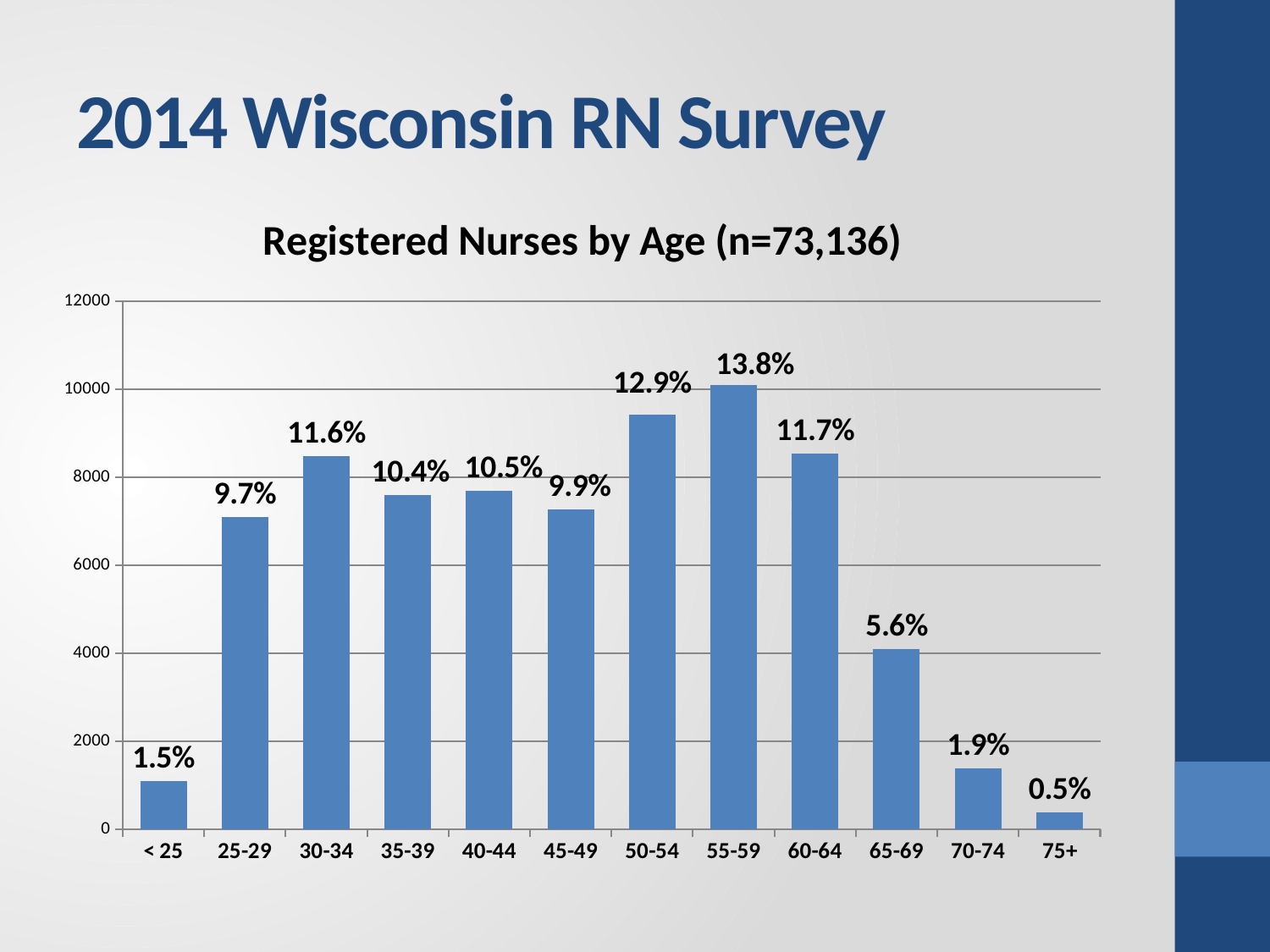
What percentage label is shown for the 30-34 age group? 11.6% What percentage label is shown for the 65-69 age group? 5.6% What is the difference in percentage points between the 55-59 and 50-54 labels? 0.9 What kind of chart is shown on the slide? bar chart Is the bar for the 50-54 age group greater or less than 8000? greater How many age groups are shown on the x axis? 12 What percentage label is shown for the < 25 age group? 1.5% What percentage label is shown for the 55-59 age group? 13.8% Which age group has a larger share, 25-29 or 60-64? 60-64 Which age group has the lowest bar? 75+ Which age group has the highest bar? 55-59 What is the title of the chart? Registered Nurses by Age (n=73,136)